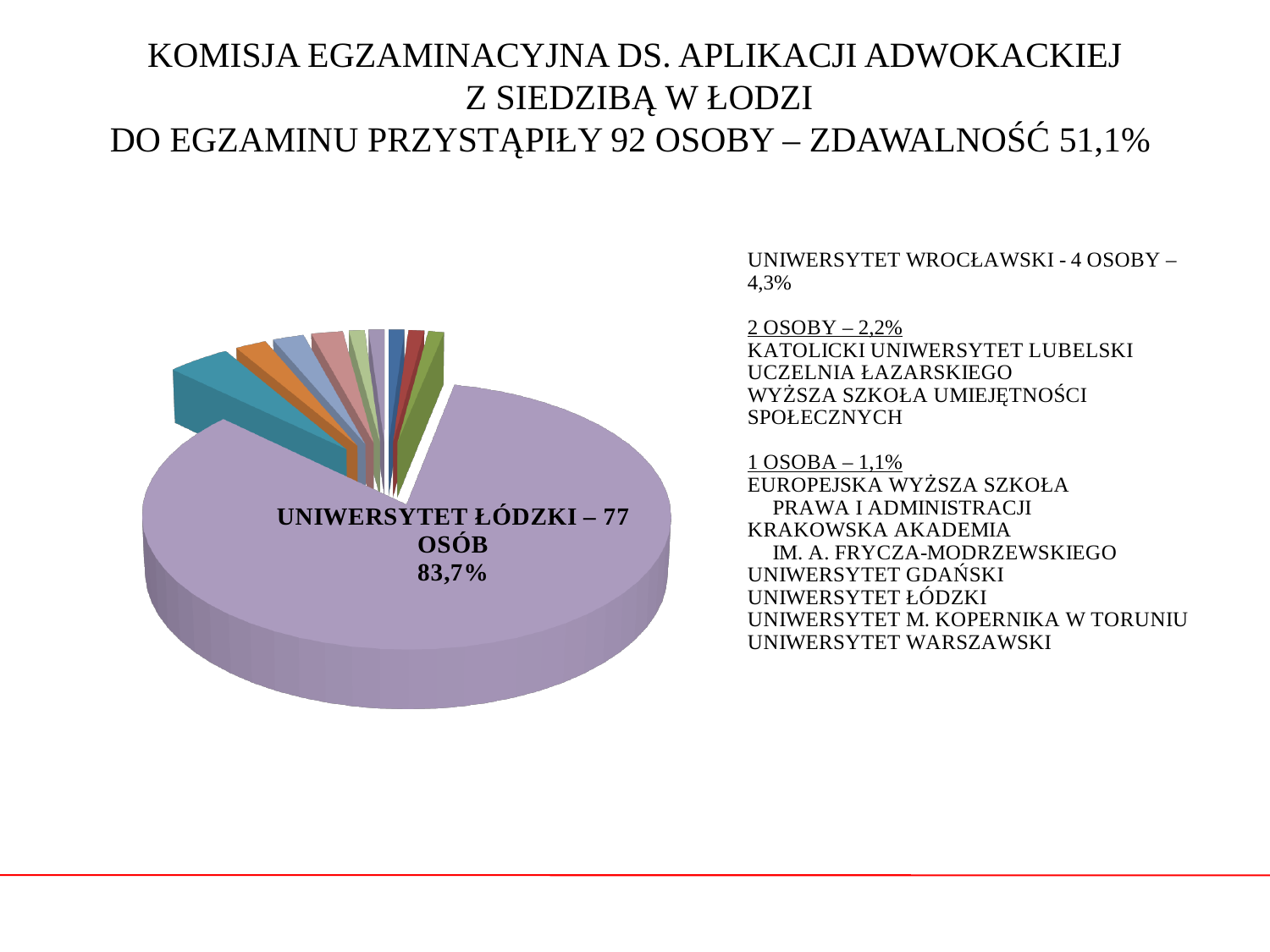
Which has more people: Uniwersytet Wrocławski or Katolicki Uniwersytet Lubelski? Uniwersytet Wrocławski What share of the pie does Uniwersytet Łódzki account for? 83,7% What percentage share is given for Uniwersytet Wrocławski? 4,3% What is the difference in number of people between Uniwersytet Łódzki (77) and Uniwersytet Wrocławski (4)? 73 According to the slide title, how many people took the exam in total? 92 How many people from Uniwersytet Wrocławski took the exam? 4 What percentage share corresponds to universities with 1 osoba? 1,1% Which university has the largest slice of the pie? Uniwersytet Łódzki What kind of chart is shown on the slide? pie chart What percentage share corresponds to universities with 2 osoby? 2,2% What is the difference in percentage points between the share of Uniwersytet Łódzki (83,7%) and Uniwersytet Wrocławski (4,3%)? 79,4% How many people (osób) from Uniwersytet Łódzki took the exam according to the chart label? 77